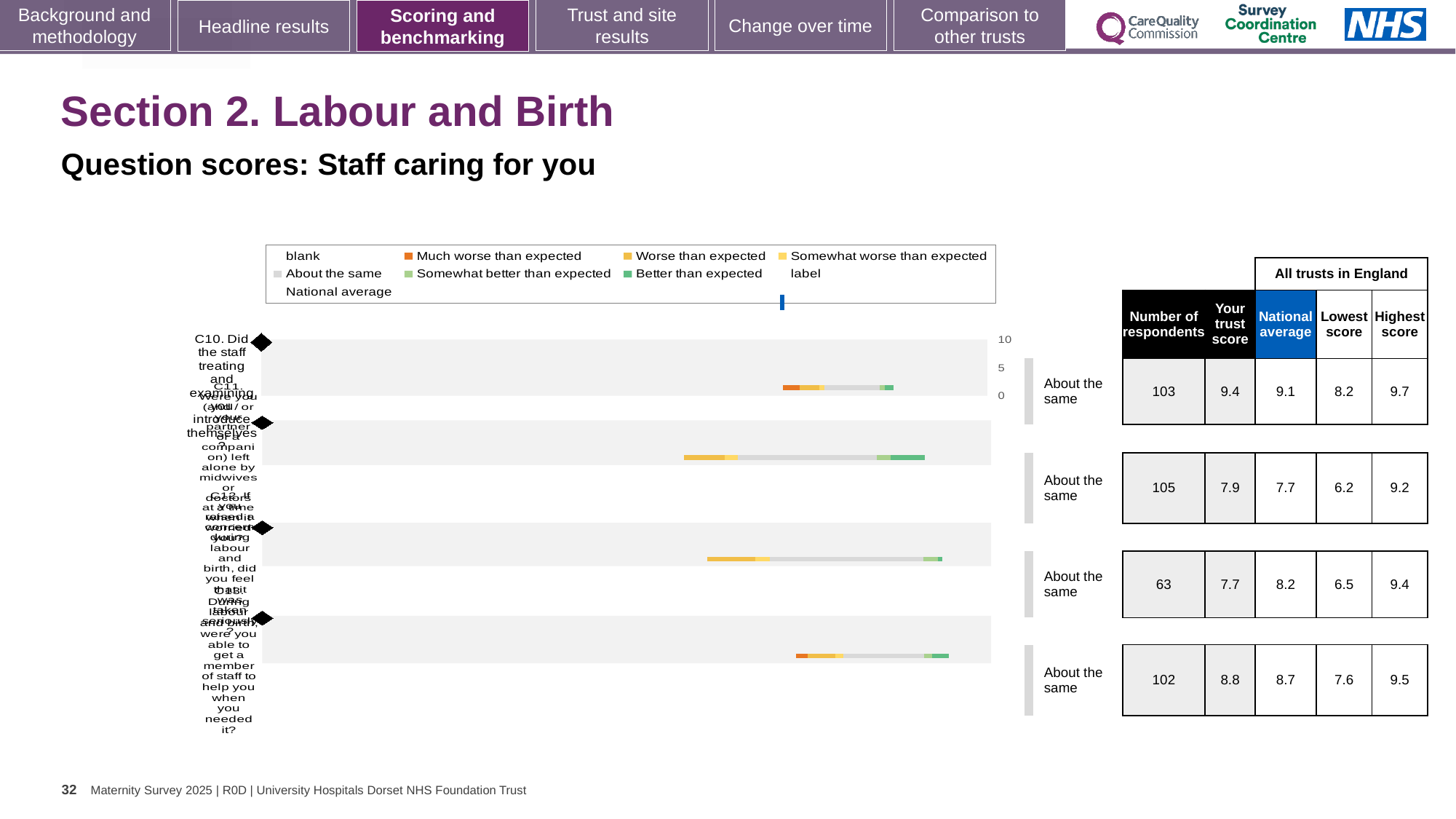
In the table, what is the 'Highest score' for the fourth (bottom) row? 9.5 In the table, what is the 'Your trust score' for the second row? 7.9 In the table, what is the 'Lowest score' for the second row? 6.2 What kind of chart is shown on the slide? bar chart How many question rows (bars) does the chart show? 4 How many entries does the chart legend list? 9 What is the subtitle describing the question scores on this slide? Question scores: Staff caring for you Which row of the table has the highest 'Your trust score'? the first row In the third row of the table, which is larger: 'Your trust score' or the 'National average'? National average In the table, what is the number of respondents for the first (top) row? 103 Which row of the table has the lowest number of respondents? the third row In the first row of the table, what is the difference between 'Your trust score' and the 'National average'? 0.3